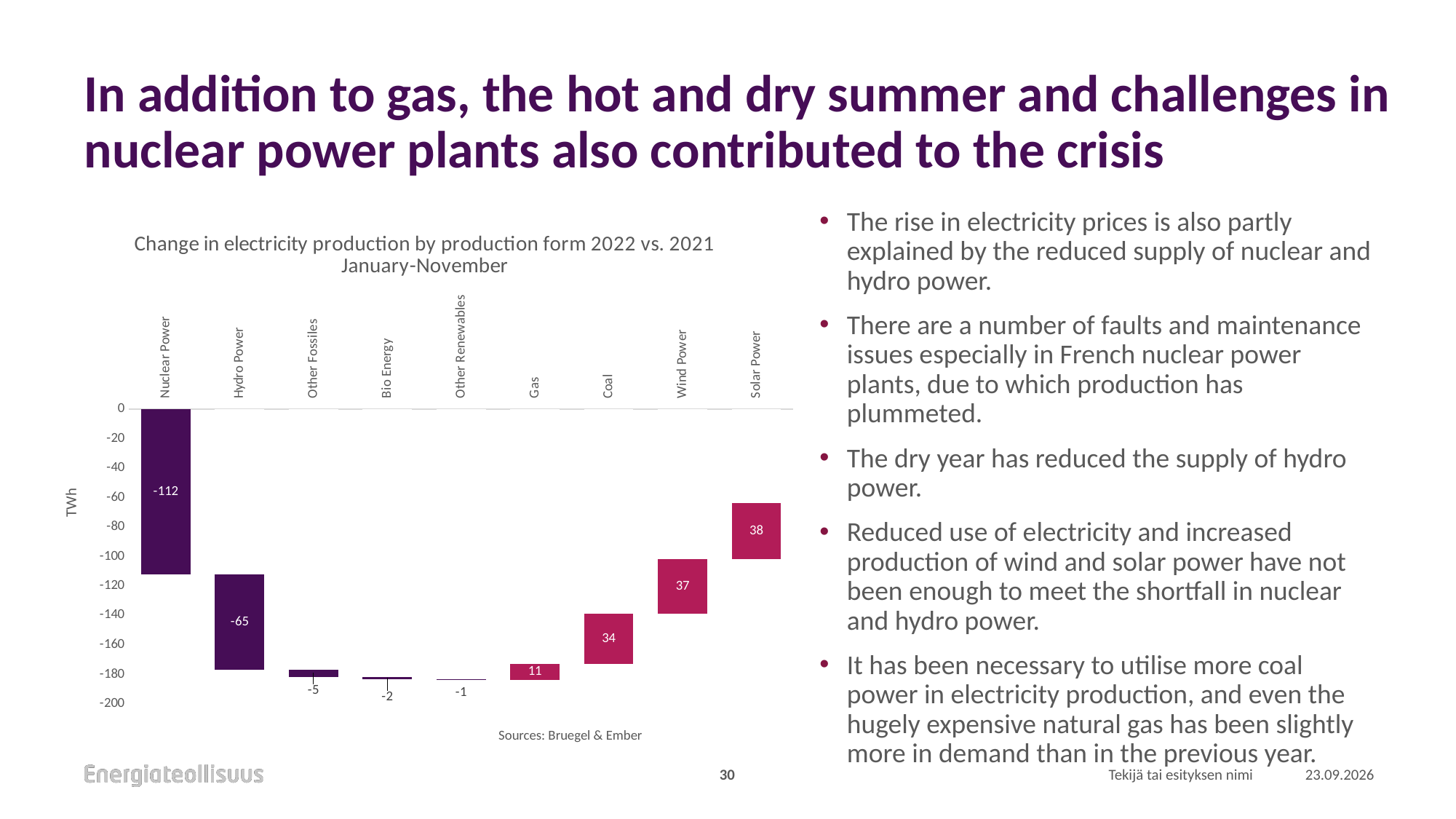
What value is shown for Coal? 34 What is the difference between the values for Coal and Gas? 23 Which has a larger increase, Wind Power or Coal? Wind Power How many production forms are shown in the chart? 9 Which production form shows the largest increase? Solar Power What value is shown for Gas? 11 Which production form shows the largest decrease? Nuclear Power What is the change in electricity production for Nuclear Power? -112 What is the difference between the values for Nuclear Power and Hydro Power? 47 What unit is shown on the vertical axis of the chart? TWh What sources are cited below the chart? Bruegel & Ember What is the change in electricity production for Hydro Power? -65